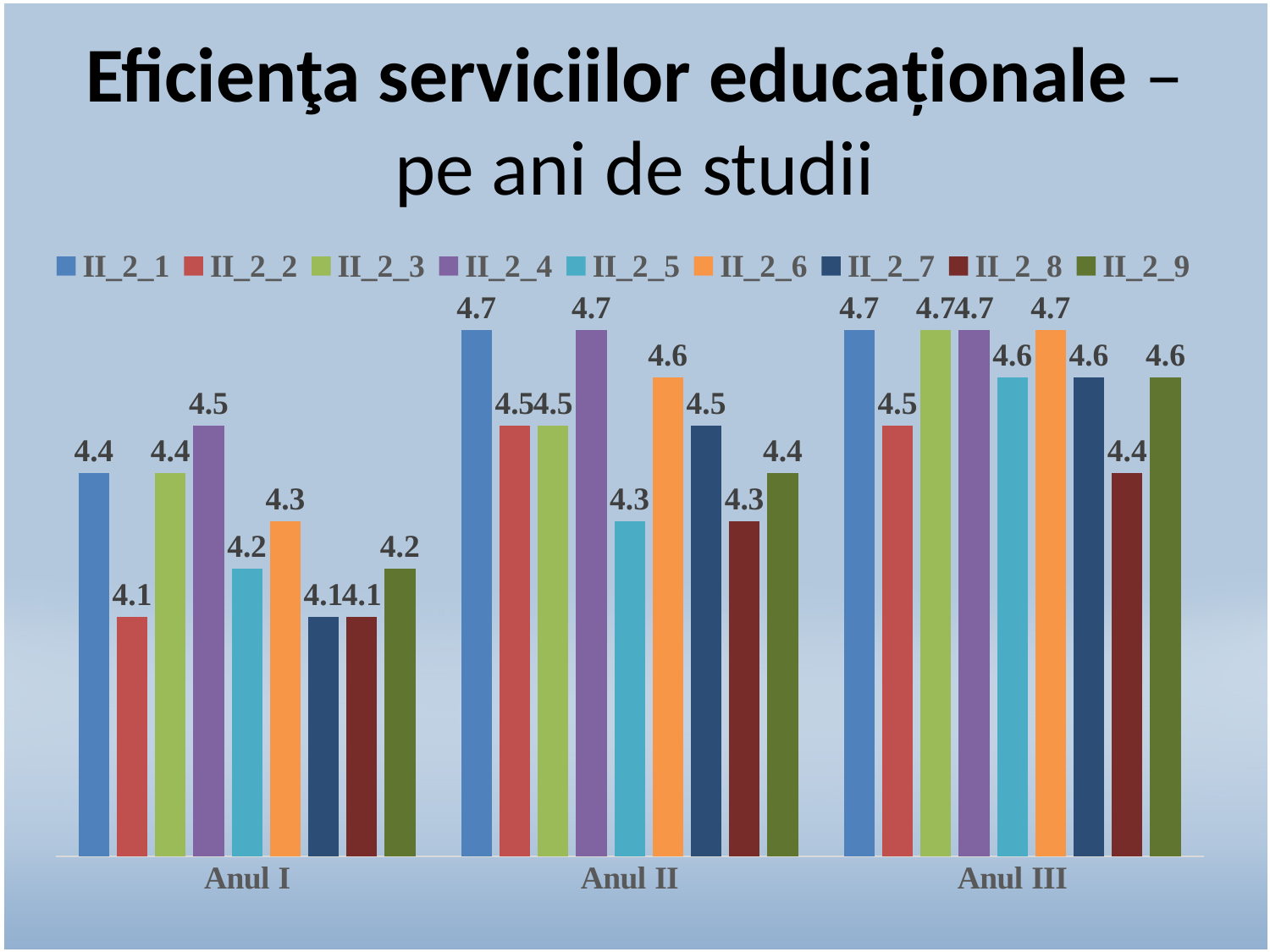
What is the value of II_2_6 for Anul II? 4.6 What is the value of II_2_8 for Anul III? 4.4 Which is larger for Anul II: the value of II_2_6 or the value of II_2_9? II_2_6 How many series does the legend list? 9 What kind of chart is shown on the slide? Bar chart How many categories are shown on the x axis? 3 What is the value of II_2_4 for Anul I? 4.5 Does the value of II_2_5 rise or fall from Anul I to Anul III? Rise What is the difference between the II_2_1 values for Anul II and Anul I? 0.3 Which series has the highest value for Anul I? II_2_4 Which series has the lowest value for Anul III? II_2_8 What is the value of II_2_5 for Anul II? 4.3